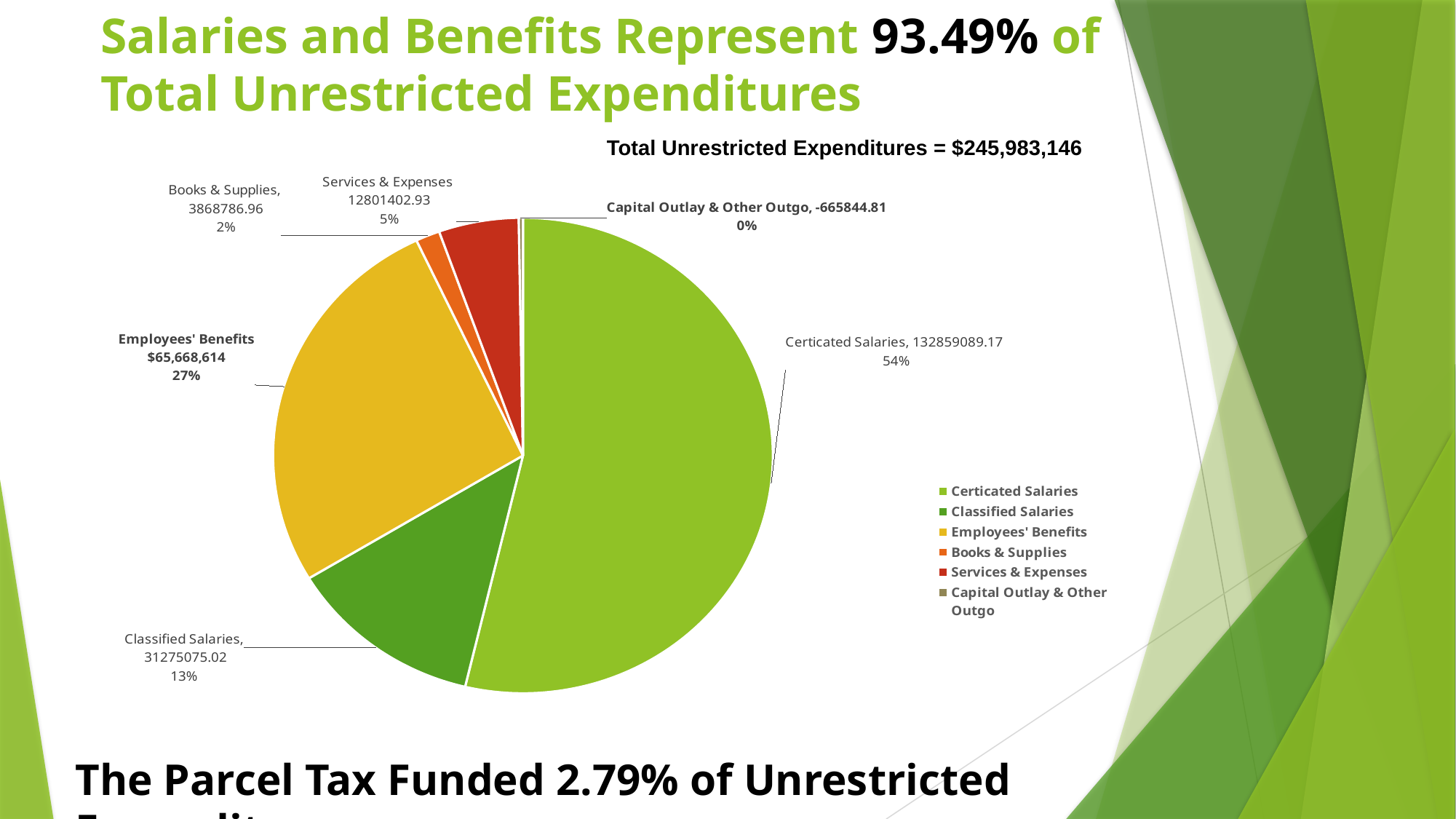
What value is shown for Certicated Salaries in the pie chart? 132859089.17 What type of chart is shown on the slide? pie chart Which is larger, the share for Classified Salaries or the share for Services & Expenses? Classified Salaries What share of the pie does Books & Supplies represent? 2% What value is shown for Services & Expenses in the pie chart? 12801402.93 What value is shown for Employees' Benefits in the pie chart? $65,668,614 What share of the pie does Employees' Benefits represent? 27% Which category has the smallest slice of the pie? Capital Outlay & Other Outgo How many entries does the legend of the pie chart list? 6 By how many percentage points does the Certicated Salaries share exceed the Employees' Benefits share? 27% What value is shown for Classified Salaries in the pie chart? 31275075.02 Which category has the largest slice of the pie? Certicated Salaries